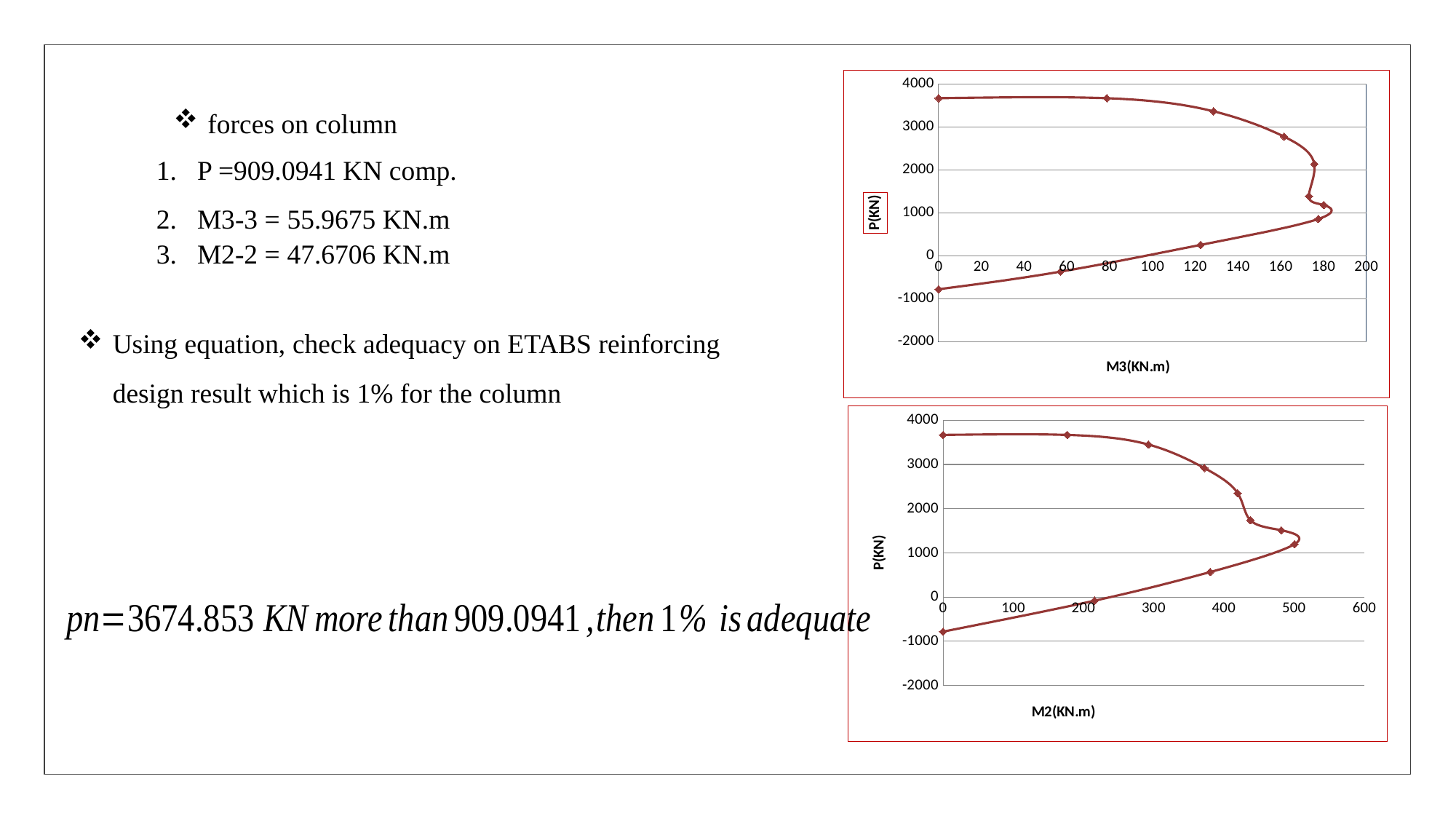
In the top chart, is the highest P(KN) value plotted greater or less than 3000? greater In the bottom chart, is the largest M2(KN.m) value reached by the curve greater or less than 600? less What kind of chart is the bottom chart on the slide? line chart In the top chart, is the largest M3(KN.m) value reached by the curve greater or less than 200? less In the bottom chart, what is the title of the horizontal axis? M2(KN.m) In the top chart, what is the title of the horizontal axis? M3(KN.m) What kind of chart is the top chart on the slide? line chart